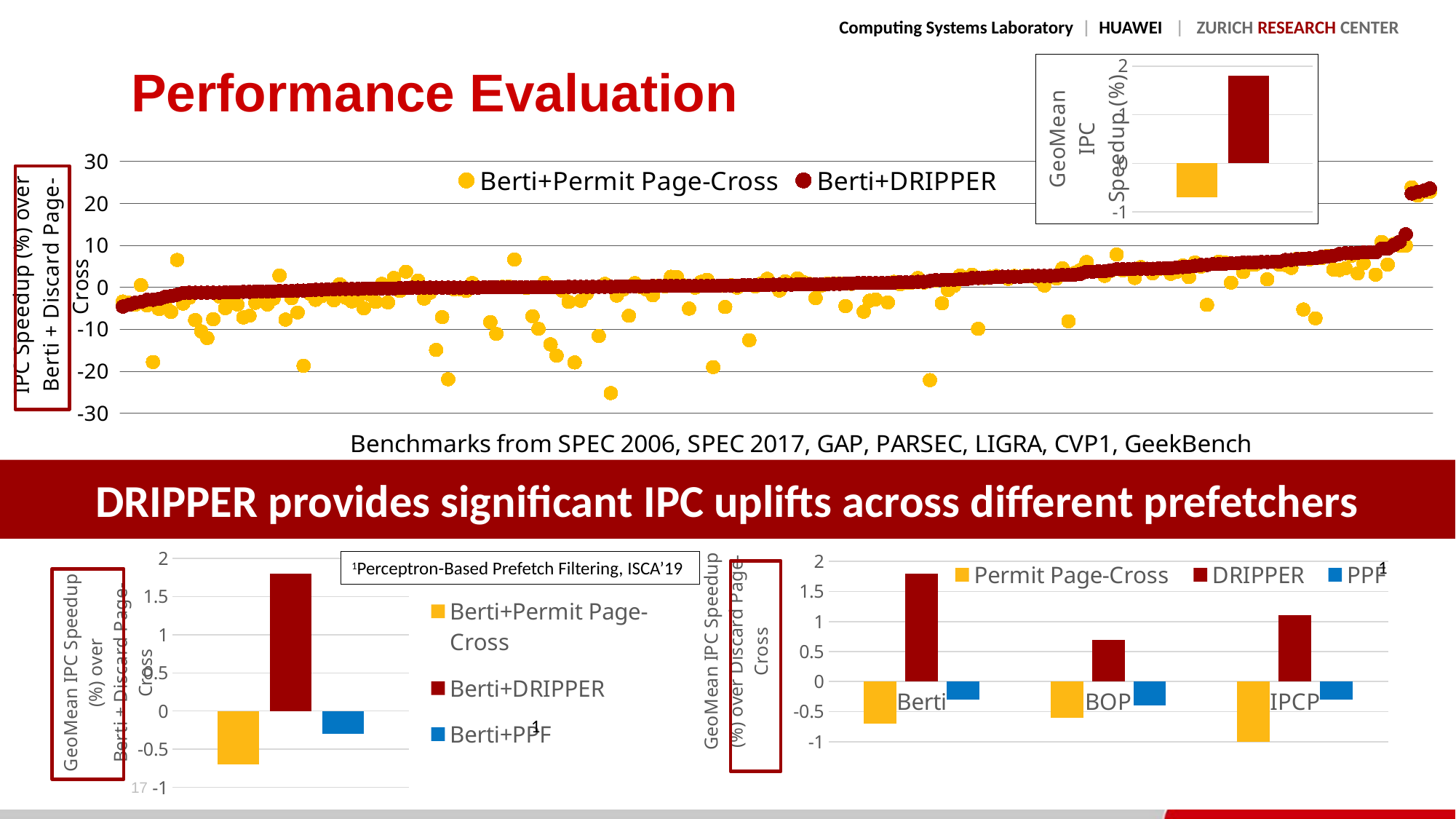
In the bottom-left bar chart, is the value for Berti+Permit Page-Cross greater or less than -0.5? less In the bottom-left bar chart, which series has the lowest value? Berti+Permit Page-Cross In the large top scatter chart, do the Berti+DRIPPER values rise or fall along the x axis? rise How many series does the legend of the large top scatter chart list? 2 What kind of chart is the large chart at the top of the slide? scatter chart What is the x-axis label of the large top scatter chart? Benchmarks from SPEC 2006, SPEC 2017, GAP, PARSEC, LIGRA, CVP1, GeekBench In the bottom-left bar chart, is the value for Berti+DRIPPER greater or less than 1.5? greater In the bottom-right bar chart, is the DRIPPER value for BOP greater or less than 1? less In the bottom-left bar chart, which series has the highest value? Berti+DRIPPER What kind of chart is the bottom-left chart? bar chart How many prefetcher categories are shown on the x axis of the bottom-right bar chart? 3 In the bottom-right bar chart, which category has the highest DRIPPER value? Berti